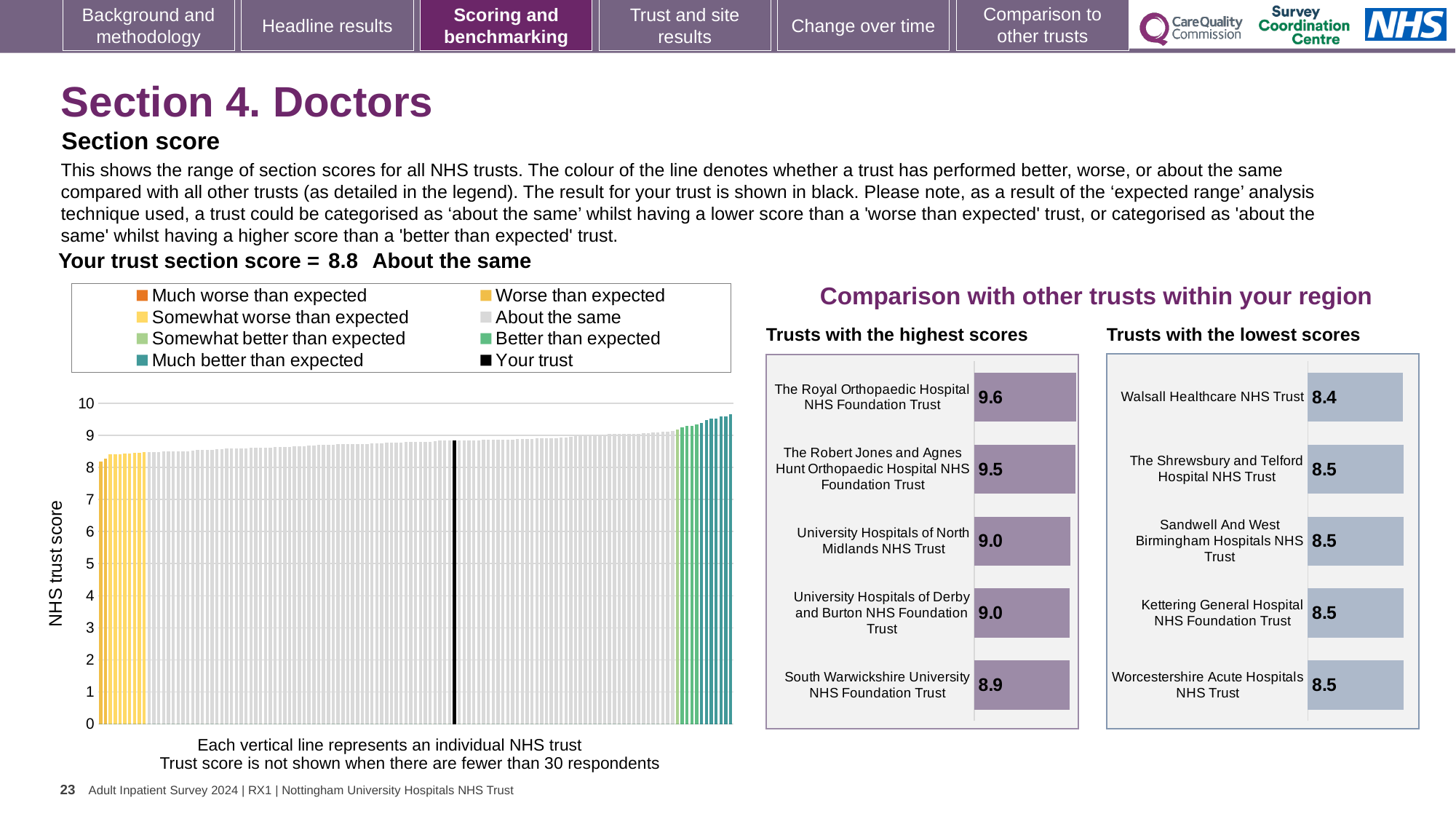
What kind of chart is the main NHS trust score chart on the left? bar chart In the 'Trusts with the highest scores' chart, what is the score for The Royal Orthopaedic Hospital NHS Foundation Trust? 9.6 Which is larger: the score for The Robert Jones and Agnes Hunt Orthopaedic Hospital NHS Foundation Trust in the highest scores chart, or the score for Worcestershire Acute Hospitals NHS Trust in the lowest scores chart? The Robert Jones and Agnes Hunt Orthopaedic Hospital NHS Foundation Trust In the 'Trusts with the lowest scores' chart, which trust has the lowest score? Walsall Healthcare NHS Trust How many entries does the legend of the main NHS trust score chart on the left list? 8 In the 'Trusts with the lowest scores' chart, what is the difference between the scores of Kettering General Hospital NHS Foundation Trust and Walsall Healthcare NHS Trust? 0.1 How many trusts are shown in the 'Trusts with the highest scores' chart? 5 In the main NHS trust score chart on the left, is the value for your trust greater or less than 8? greater In the 'Trusts with the highest scores' chart, what is the score for South Warwickshire University NHS Foundation Trust? 8.9 In the 'Trusts with the lowest scores' chart, what is the score for Walsall Healthcare NHS Trust? 8.4 In the 'Trusts with the highest scores' chart, which trust has the highest score? The Royal Orthopaedic Hospital NHS Foundation Trust In the 'Trusts with the highest scores' chart, what is the difference between the scores of The Royal Orthopaedic Hospital NHS Foundation Trust and South Warwickshire University NHS Foundation Trust? 0.7